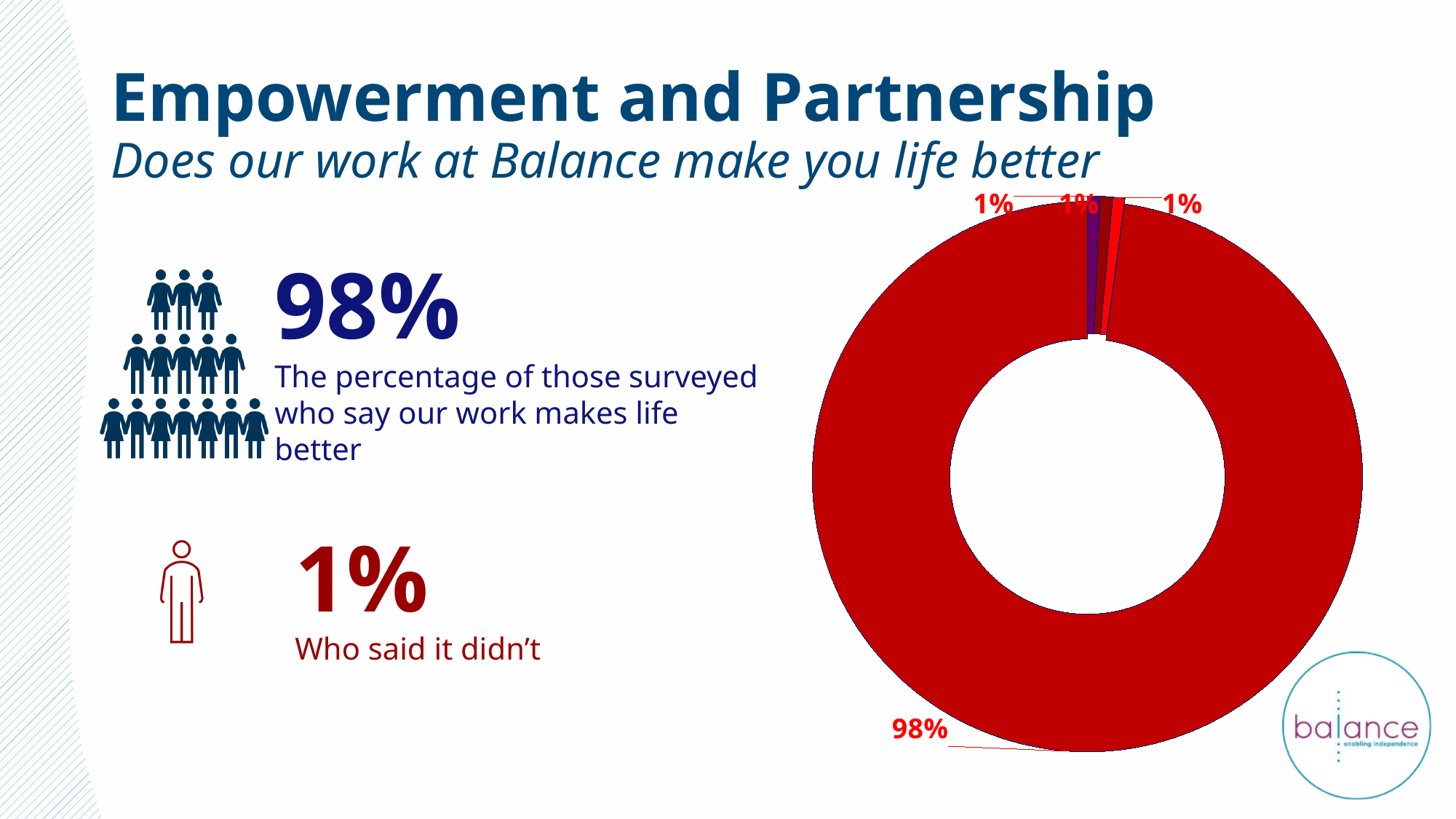
What share of the doughnut chart does the largest slice represent? 98% Which is larger: the slice labelled 98% or a slice labelled 1%? The slice labelled 98% According to the slide text, what percentage of those surveyed say the work makes life better? 98% What is the difference between the largest slice (98%) and one of the 1% slices? 97% What percentage is shown on the smallest slices of the doughnut chart? 1% What is the total of the three 1% slices in the doughnut chart? 3% What colour is the largest slice of the doughnut chart? Red What percentage is shown on the largest slice of the doughnut chart? 98% How many slices does the doughnut chart have? 4 How many slices of the doughnut chart are labelled 1%? 3 Is the largest slice of the doughnut chart greater or less than 50%? greater What kind of chart is shown on the slide? Doughnut (pie) chart